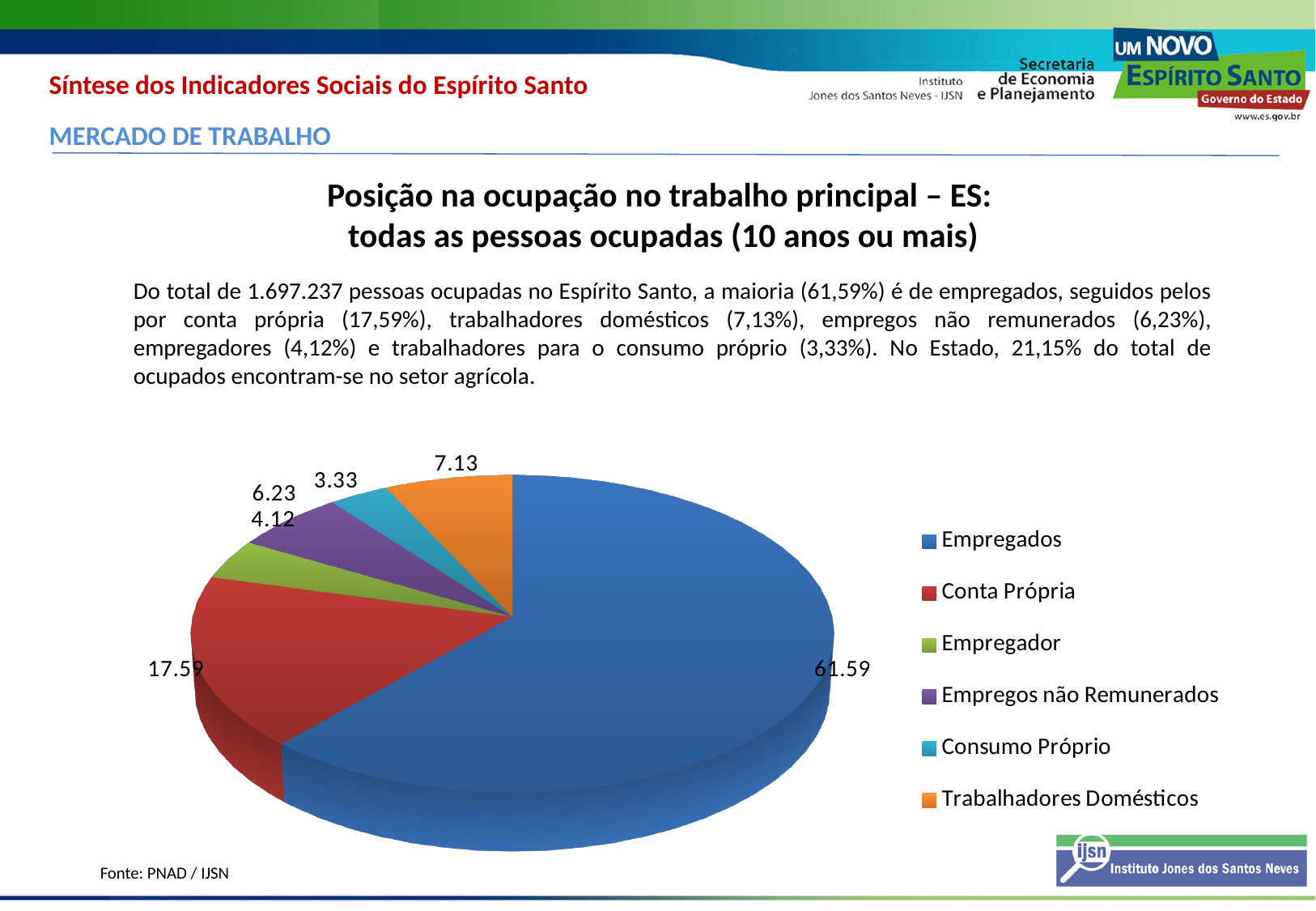
What is the value shown for Empregos não Remunerados in the pie chart? 6.23 What is the value shown for Trabalhadores Domésticos in the pie chart? 7.13 How many categories does the legend of the pie chart list? 6 What colour is the slice for Trabalhadores Domésticos in the pie chart? orange What is the value shown for Empregados in the pie chart? 61.59 Which is larger, the value for Empregador or the value for Empregos não Remunerados? Empregos não Remunerados Which category has the smallest slice of the pie chart? Consumo Próprio What is the value shown for Consumo Próprio in the pie chart? 3.33 What type of chart is shown on the slide? pie chart What is the difference between the values for Empregados and Conta Própria? 44.00 What is the value shown for Conta Própria in the pie chart? 17.59 Which category has the largest slice of the pie chart? Empregados